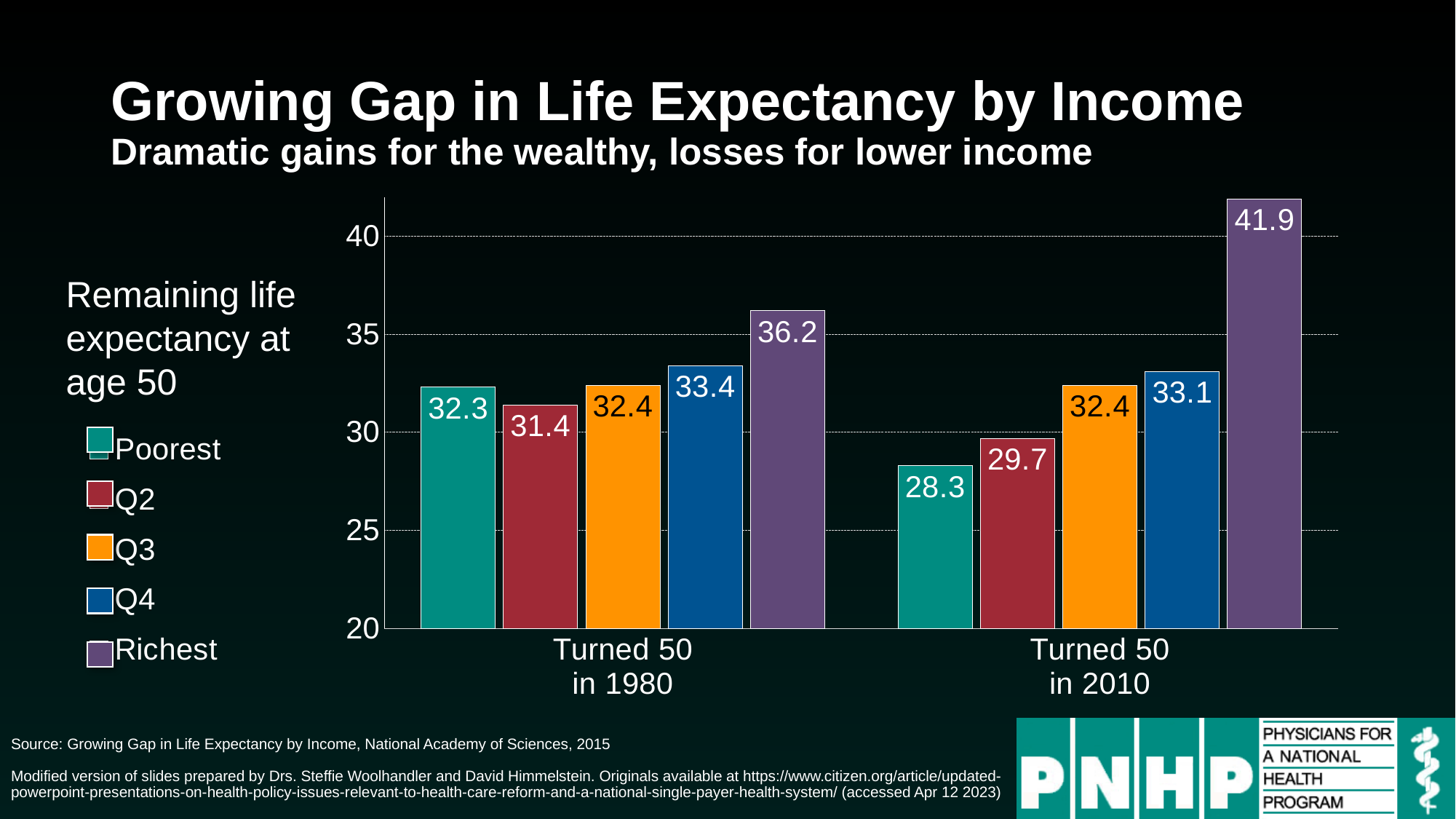
By how much did the Richest group's remaining life expectancy change from the 1980 cohort to the 2010 cohort? 5.7 What is the remaining life expectancy at age 50 for the Richest group who turned 50 in 2010? 41.9 Is the value for Q4 in the 2010 cohort greater or less than 30? greater What is the difference between the Richest and Poorest values for those who turned 50 in 2010? 13.6 Which income group has the highest remaining life expectancy among those who turned 50 in 2010? Richest How many series does the legend list? 5 What is the value for Q2 among those who turned 50 in 2010? 29.7 What colour are the bars for the Q3 group? Orange What is the remaining life expectancy at age 50 for the Poorest group who turned 50 in 1980? 32.3 Which income group has the lowest remaining life expectancy among those who turned 50 in 1980? Q2 Which is larger: the Poorest value for the 1980 cohort or the Poorest value for the 2010 cohort? 1980 cohort What kind of chart is shown on the slide? Bar chart